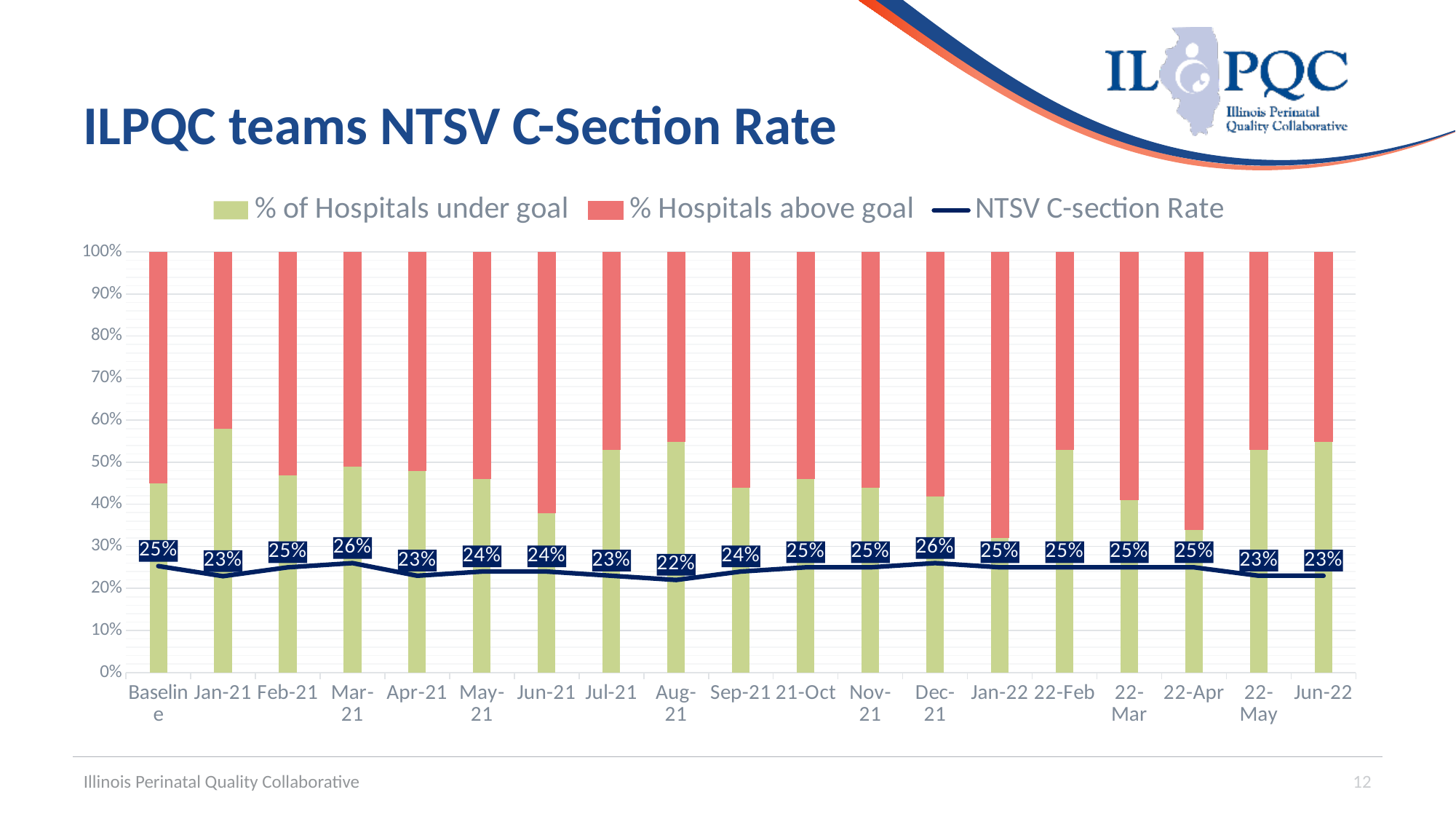
What is the NTSV C-section Rate for Jun-22? 23% What is the difference between the NTSV C-section Rate in Mar-21 and in Aug-21? 4 percentage points In which month is the NTSV C-section Rate lowest? Aug-21 Is the % of Hospitals under goal for Jan-21 greater or less than 50%? greater Which has a higher NTSV C-section Rate, Jan-21 or Feb-21? Feb-21 What is the NTSV C-section Rate for Aug-21? 22% How many series does the legend list? 3 How many time periods are shown on the x axis? 19 What kind of chart is shown on the slide? Stacked bar chart with a line What is the NTSV C-section Rate for Dec-21? 26% Is the % of Hospitals under goal for Jan-22 greater or less than 40%? less What is the NTSV C-section Rate at Baseline? 25%